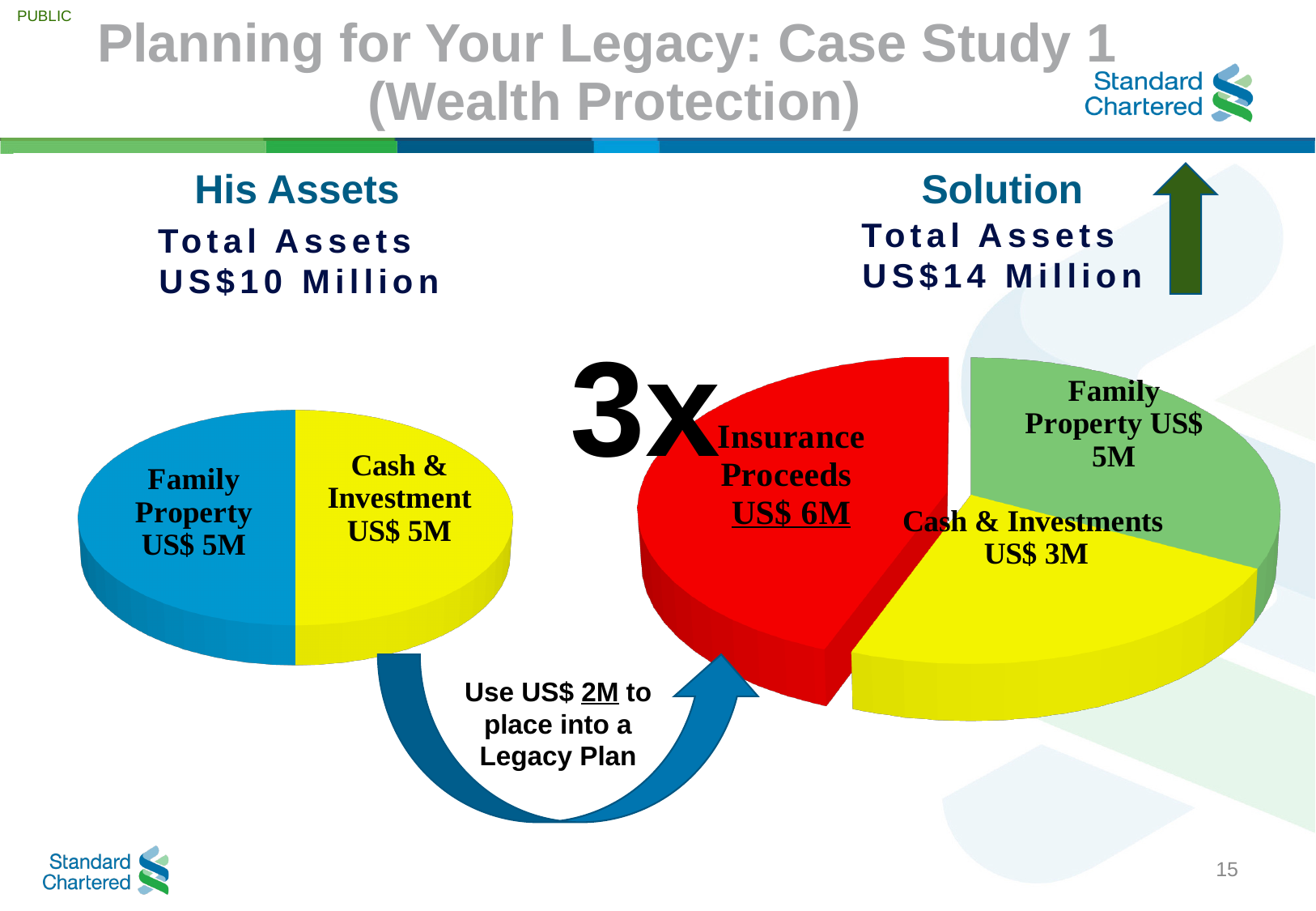
In the 'Solution' pie chart, what is the difference between Insurance Proceeds and Cash & Investments? US$ 3M In the 'Solution' pie chart, which slice is the smallest? Cash & Investments In the 'Solution' pie chart, which slice is the largest? Insurance Proceeds How many slices does the 'Solution' pie chart have? 3 What type of chart is used for 'His Assets'? Pie chart In the 'His Assets' pie chart, what is the value of Family Property? US$ 5M In the 'Solution' pie chart, what is the value of Cash & Investments? US$ 3M In the 'Solution' pie chart, what is the value of Family Property? US$ 5M In the 'His Assets' pie chart, what is the value of Cash & Investment? US$ 5M In the 'Solution' pie chart, what is the value of Insurance Proceeds? US$ 6M In the 'Solution' pie chart, which is larger: Family Property or Cash & Investments? Family Property In the 'His Assets' pie chart, what colour is the Family Property slice? Blue